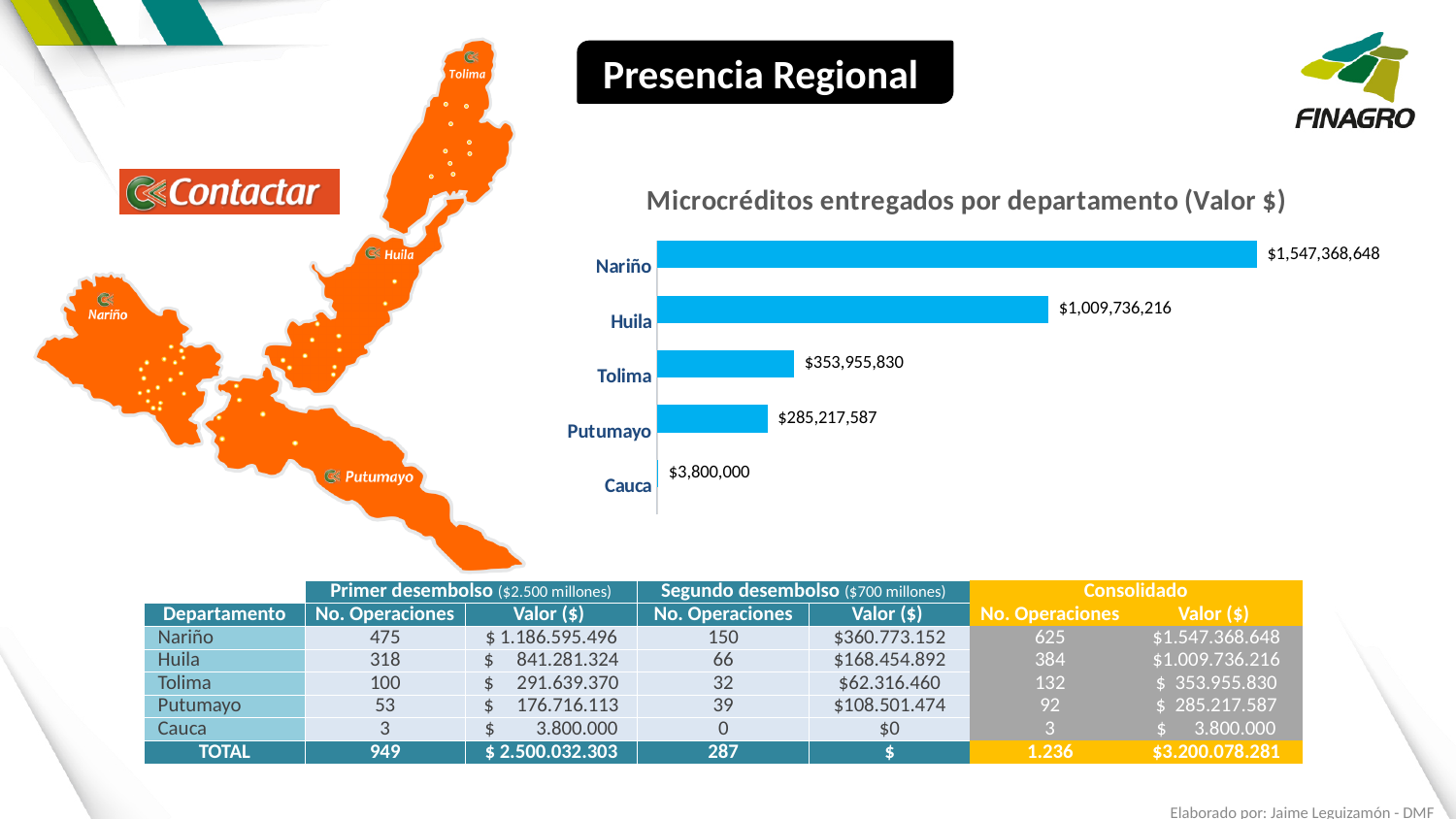
Which department has the highest value in the chart? Nariño What is the value shown for Putumayo in the chart? $285,217,587 What is the difference between the values for Nariño and Huila? $537,632,432 What is the difference between the values for Tolima and Putumayo? $68,738,243 What is the value shown for Tolima in the chart? $353,955,830 What is the value shown for Nariño in the chart? $1,547,368,648 What is the value shown for Cauca in the chart? $3,800,000 What type of chart is used to show the microcredits by department? Bar chart Which has a larger value, Huila or Tolima? Huila Which department has the lowest value in the chart? Cauca How many departments are shown in the chart? 5 What is the value shown for Huila in the chart? $1,009,736,216